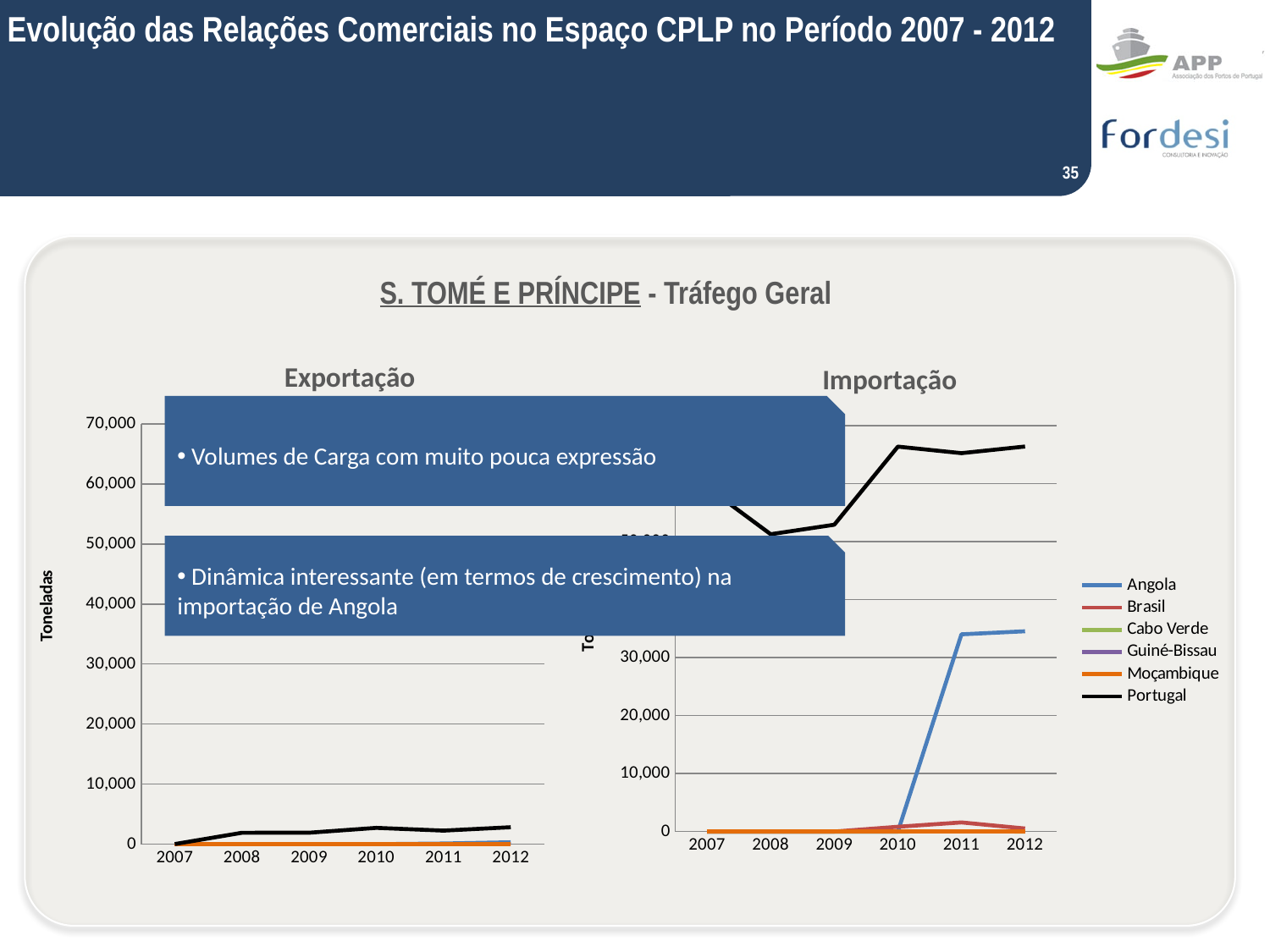
In the Importação chart, is the value for Angola in 2010 greater or less than 10,000? less In the Exportação chart, is the value for Portugal in 2012 greater or less than 10,000? less In the Importação chart, does the Angola line rise or fall from 2010 to 2011? rise In the Importação chart, which series has the highest value in 2012? Portugal How many series does the legend list? 6 What kind of chart is the Exportação chart? line chart In the Importação chart, is the value for Portugal in 2008 greater or less than 60,000? less Which country is shown in black in the legend? Portugal In the Importação chart, which is larger in 2012: Portugal or Angola? Portugal How many years are shown on the x axis of the Importação chart? 6